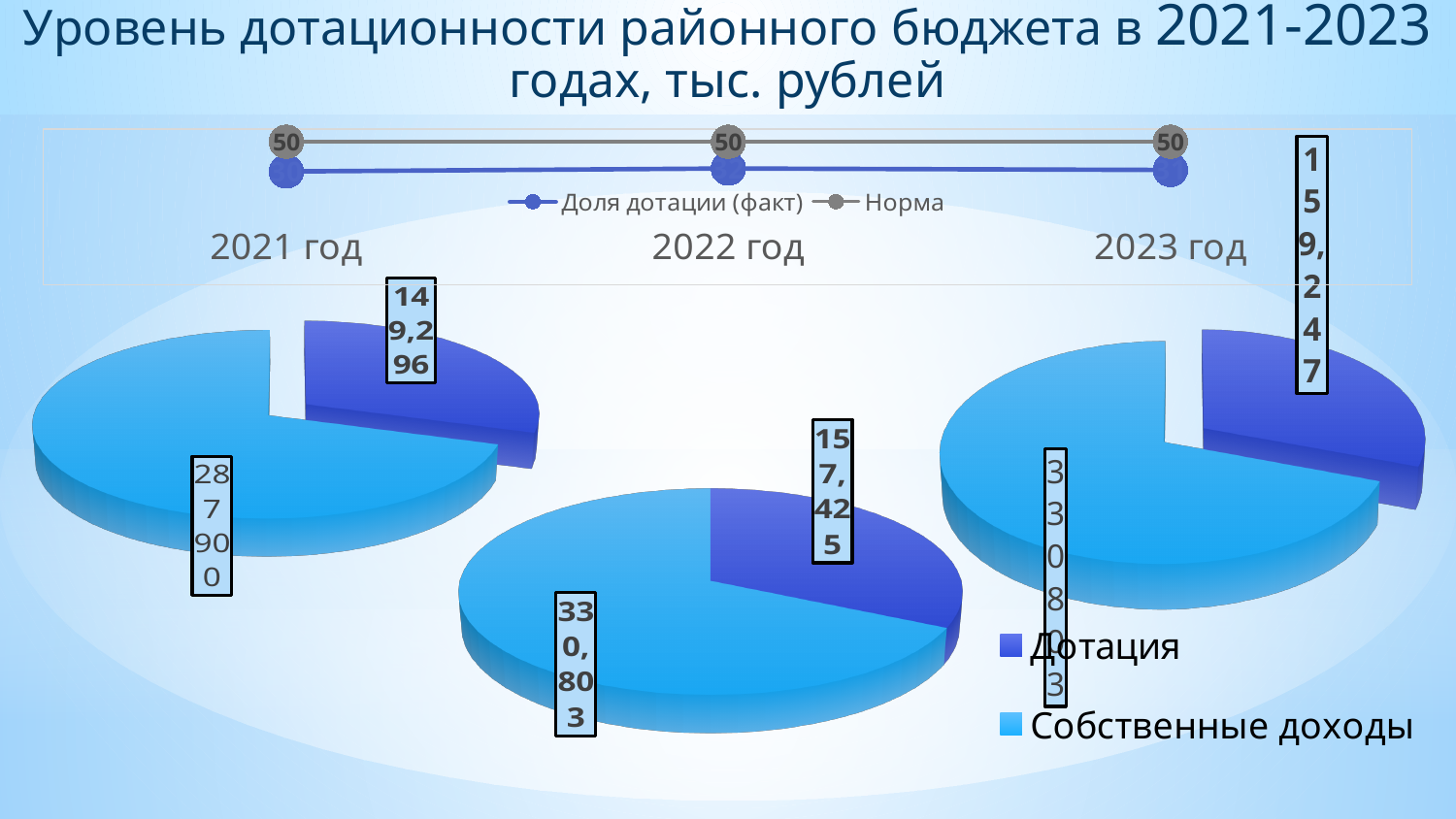
Which colour represents 'Дотация' in the pie charts' legend? dark blue How many years (points) are shown along the x axis of the top line chart? 3 How many series does the legend of the top line chart list? 2 In the 2022 год pie chart, what is the value for 'Собственные доходы'? 330,803 In the top line chart, what value is labelled for the 'Норма' series in 2022 год? 50 In the 2021 год pie chart, what is the value for 'Собственные доходы'? 287900 In the 2021 год pie chart, which slice is larger, 'Дотация' or 'Собственные доходы'? Собственные доходы What kind of chart is shown at the top of the slide with the series 'Доля дотации (факт)' and 'Норма'? line chart In the 2021 год pie chart, what is the value for 'Дотация'? 149,296 In the 2023 год pie chart, what is the value for 'Дотация'? 159,247 What kind of charts are the three charts in the lower part of the slide? pie charts In the 2022 год pie chart, what is the value for 'Дотация'? 157,425